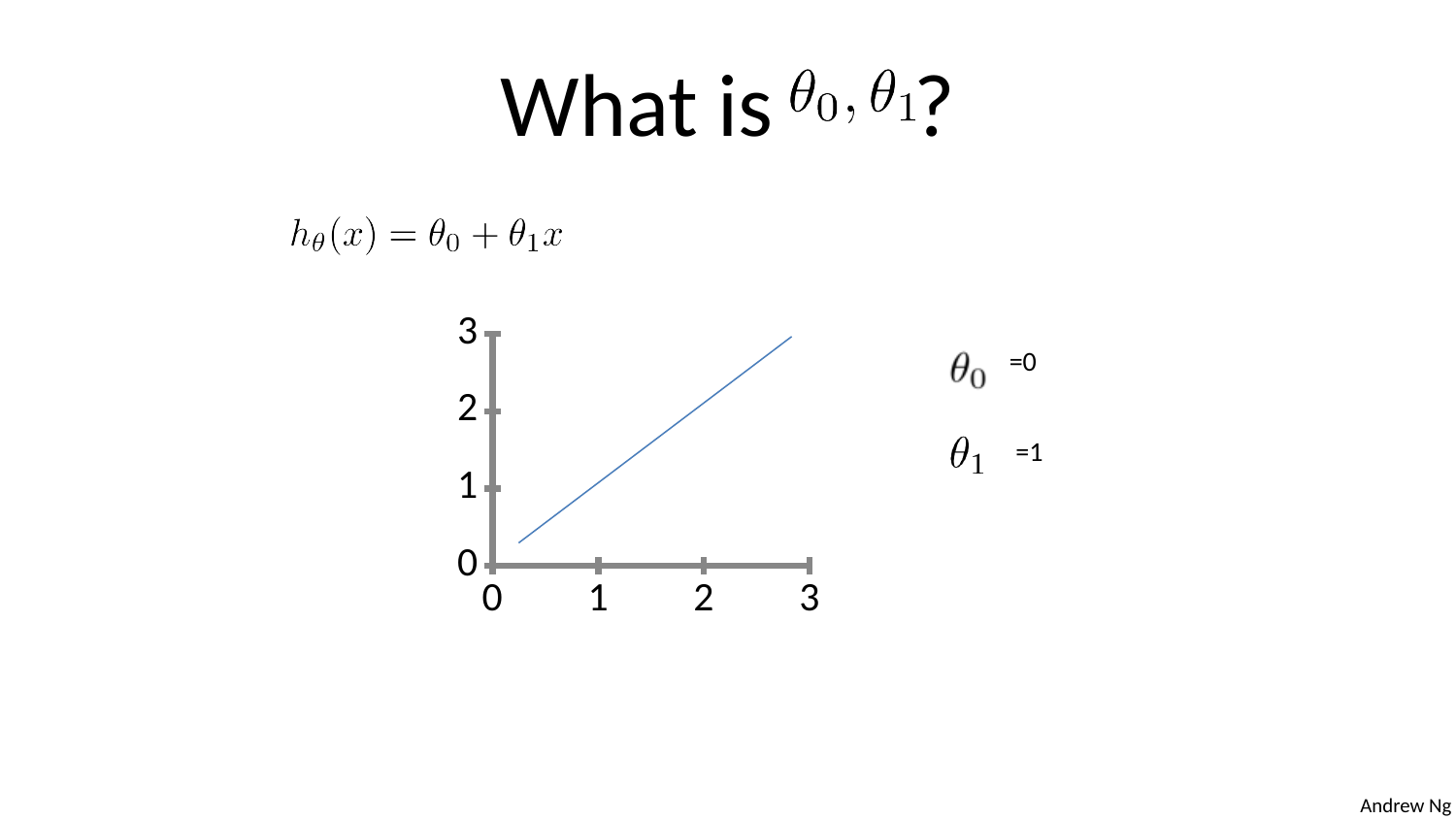
Is the value of the line at x = 2 greater or less than 3? less How many tick labels are shown on the x axis? 4 Is the value of the line at x = 2 greater or less than 1? greater What kind of chart is shown on the slide? line chart Does the plotted line rise or fall as x increases from 0 to 3? rises Is the lowest point of the plotted line greater or less than 1? less What is the largest value labelled on the y axis? 3 What colour is the plotted line? blue How many lines are plotted on the chart? 1